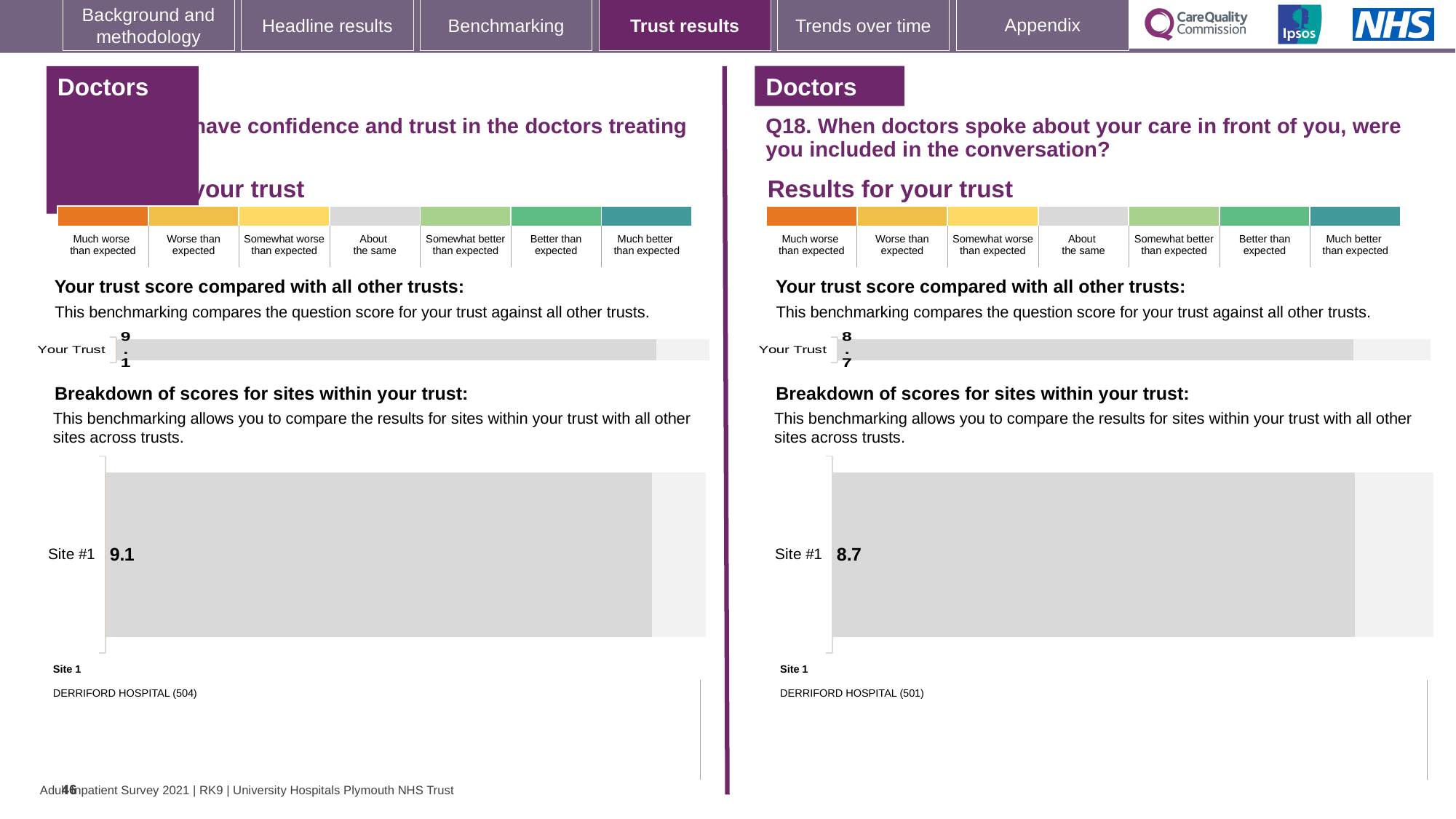
Which site is listed as Site 1 in the Q18 section on the right? DERRIFORD HOSPITAL (501) Is the Site #1 score for Q18 greater or less than the Site #1 score on the left half of the slide? less Which site is listed as Site 1 on the left half of the slide? DERRIFORD HOSPITAL (504) What type of chart is used to show the Site #1 score in the Q18 section? Bar chart What is the difference between the Site #1 score on the left half of the slide and the Site #1 score for Q18 on the right? 0.4 How many sites are shown in the 'Breakdown of scores for sites within your trust' chart for Q18? 1 On the left half of the slide, what is the score shown for Your Trust in the 'Your trust score compared with all other trusts' chart? 9.1 On the left half of the slide, what score is shown for Site #1 in the 'Breakdown of scores for sites within your trust' chart? 9.1 In the Q18 section on the right, what is the score shown for Your Trust? 8.7 In the Q18 section on the right, what score is shown for Site #1 in the site breakdown chart? 8.7 Which is larger: the Your Trust score on the left half of the slide or the Your Trust score for Q18 on the right? Left half (9.1)